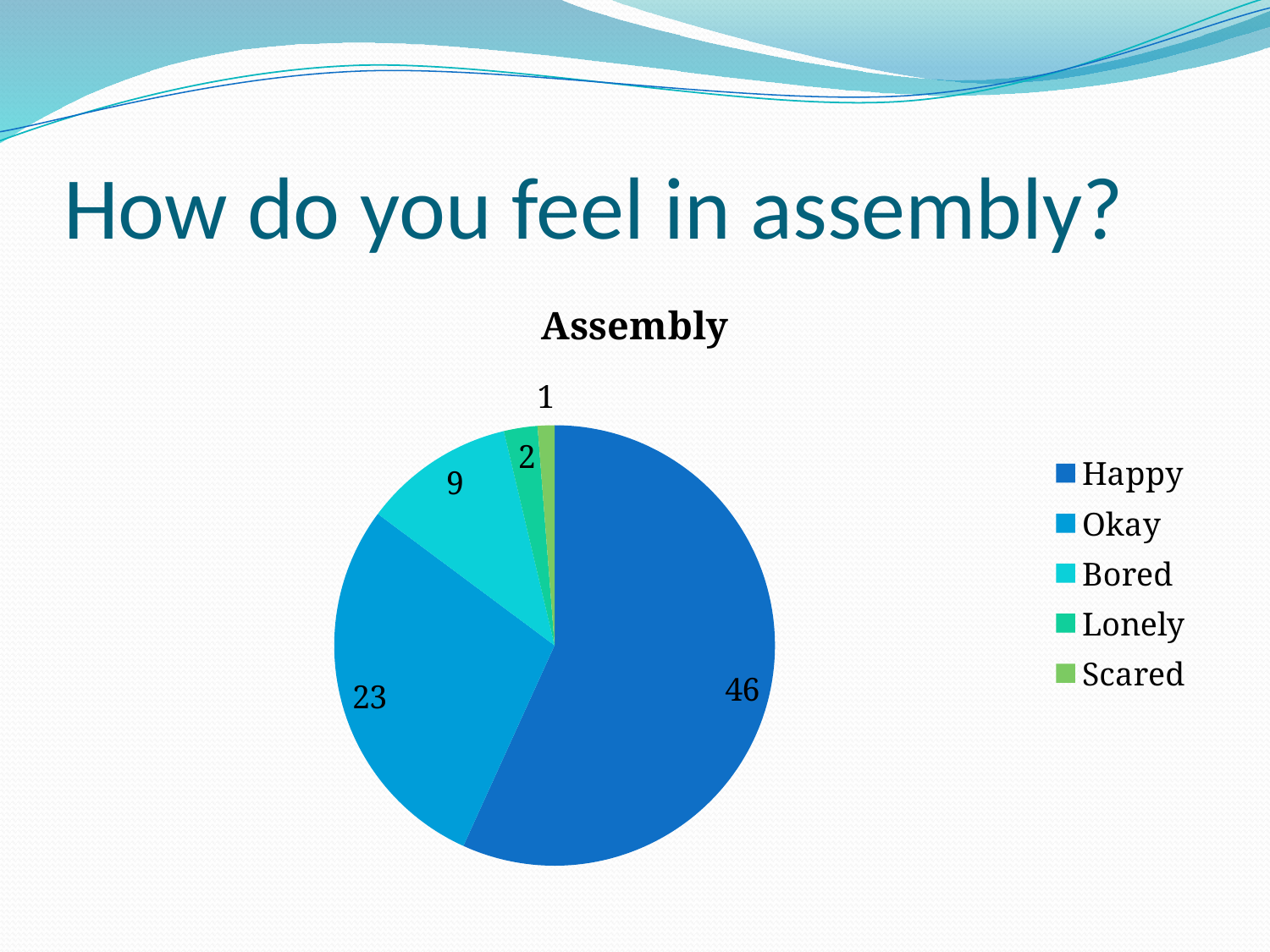
What is the value for Bored? 9 What is the value for Happy? 46 Which is larger, the value for Bored or the value for Lonely? Bored How many categories does the legend list? 5 What is the difference between the values for Happy and Okay? 23 What is the value for Scared? 1 What is the title of the chart? Assembly What type of chart is shown on the slide? pie chart What is the value for Lonely? 2 What is the value for Okay? 23 Which category has the largest slice? Happy Which category has the smallest slice? Scared